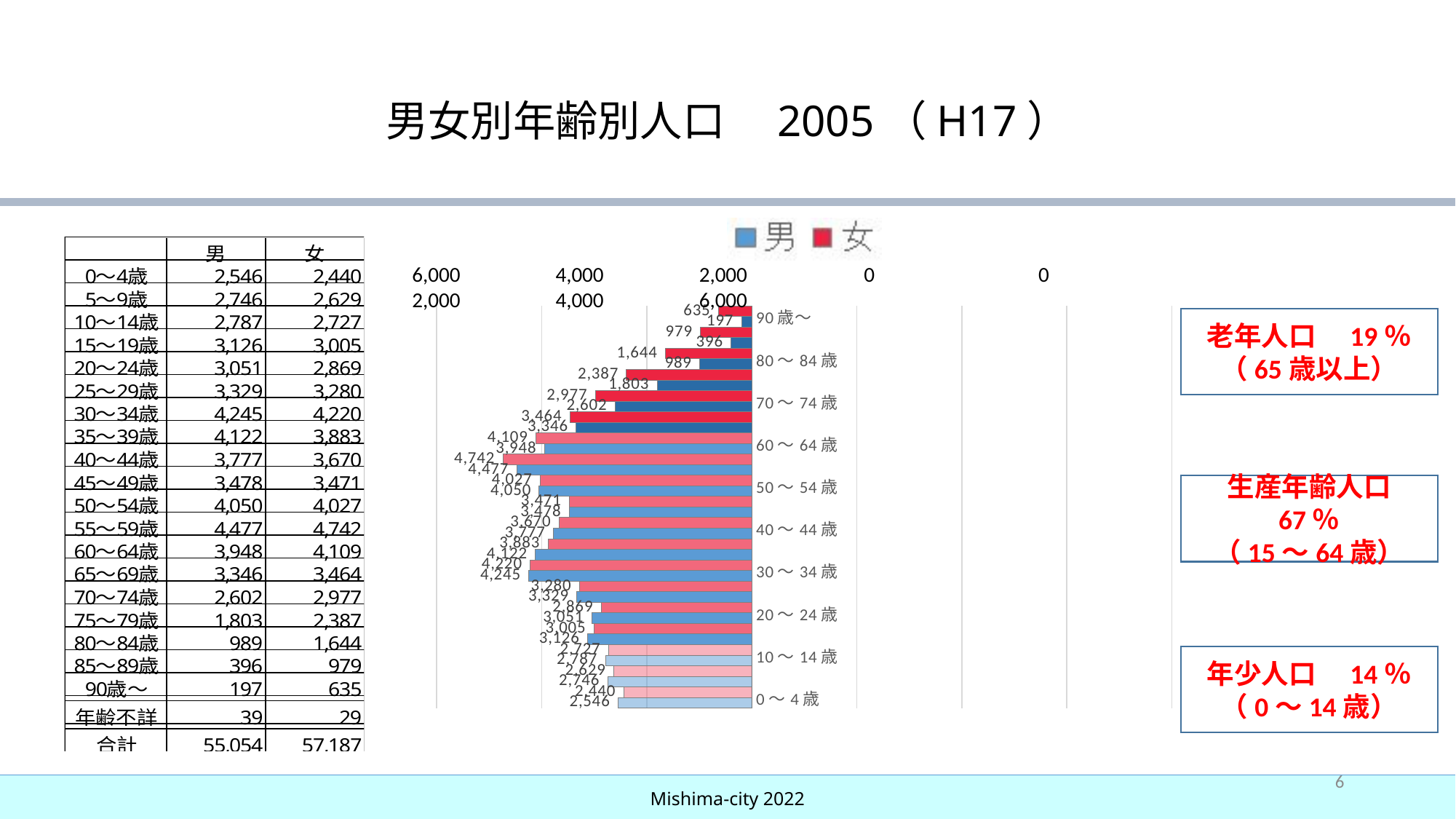
What is the 男 (male) value for the 80〜84歳 age group? 989 What is the 女 (female) value for the 90歳〜 age group? 635 What kind of chart is shown on the slide? bar chart Which age group has the highest 男 (male) value? 55〜59歳 For the 0〜4歳 age group, which is larger, the 男 value or the 女 value? 男 How many age groups are plotted on the chart? 19 Which colour represents the 女 (female) series in the legend? red What is the difference between the 女 and 男 values for the 75〜79歳 age group? 584 How many series does the chart legend list? 2 What is the 男 (male) value for the 30〜34歳 age group? 4,245 Which age group has the highest 女 (female) value? 55〜59歳 Which age group on the chart has the lowest 男 (male) value? 90歳〜